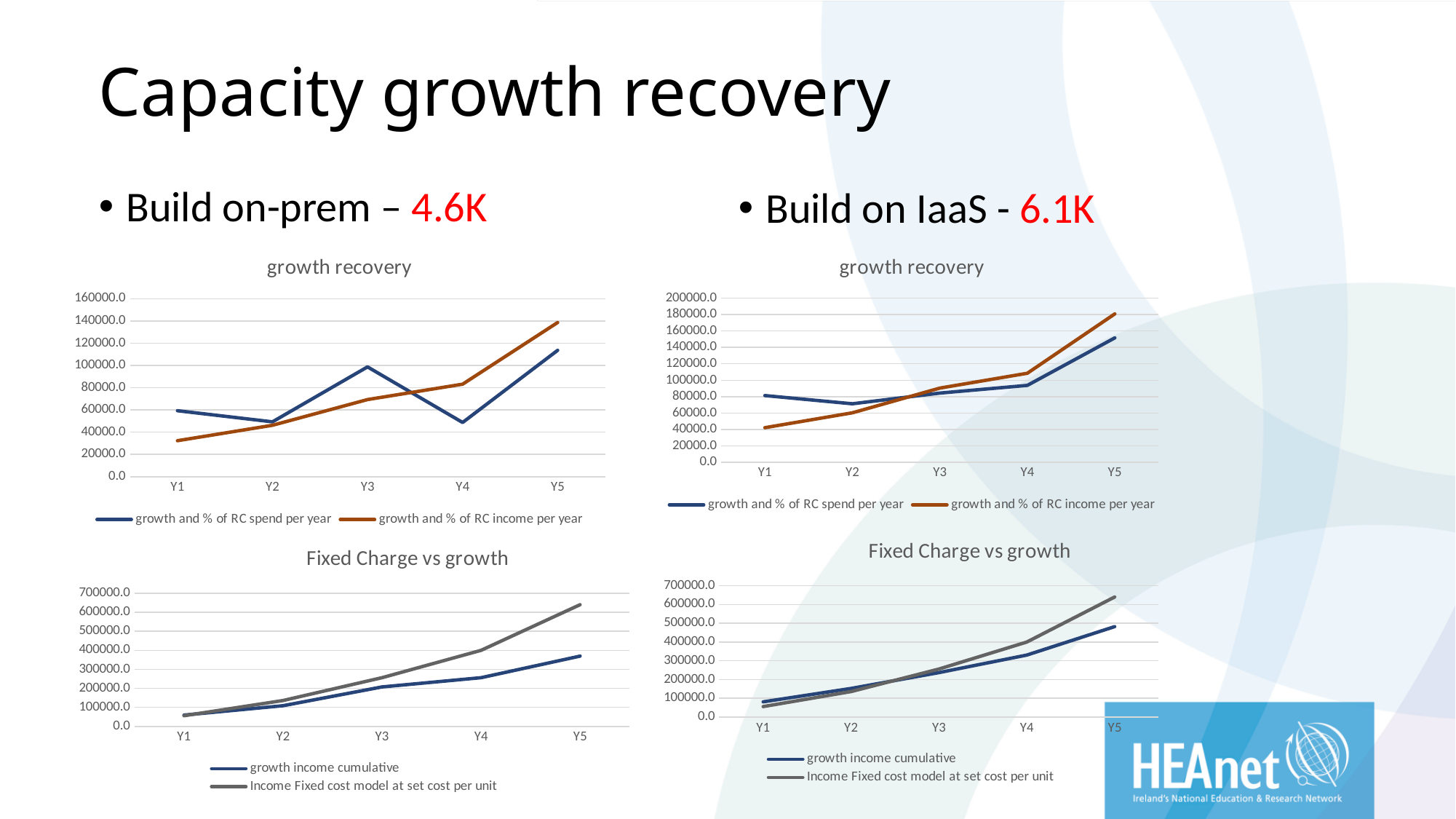
In the 'growth recovery' chart under 'Build on IaaS', is the value of 'growth and % of RC spend per year' at Y1 greater or less than 60000.0? greater In the 'Fixed Charge vs growth' chart under 'Build on IaaS', is the value of 'growth income cumulative' at Y5 greater or less than 400000.0? greater In the 'growth recovery' chart under 'Build on-prem', does the 'growth and % of RC income per year' line rise or fall from Y1 to Y5? rise How many years are shown on the x axis of the 'growth recovery' chart under 'Build on-prem'? 5 In the 'growth recovery' chart under 'Build on-prem', at which year is 'growth and % of RC spend per year' highest? Y5 In the 'growth recovery' chart under 'Build on-prem', is the value of 'growth and % of RC income per year' at Y5 greater or less than 120000.0? greater How many series does the legend of the 'growth recovery' chart under 'Build on IaaS' list? 2 In the 'growth recovery' chart under 'Build on-prem', at which year is 'growth and % of RC income per year' lowest? Y1 What are the two legend entries of the 'Fixed Charge vs growth' chart under 'Build on-prem'? growth income cumulative; Income Fixed cost model at set cost per unit In the 'Fixed Charge vs growth' chart under 'Build on-prem', which series is higher at Y5? Income Fixed cost model at set cost per unit In the 'growth recovery' chart under 'Build on IaaS', which series is higher at Y5? growth and % of RC income per year What kind of chart is the 'growth recovery' chart under 'Build on-prem'? line chart